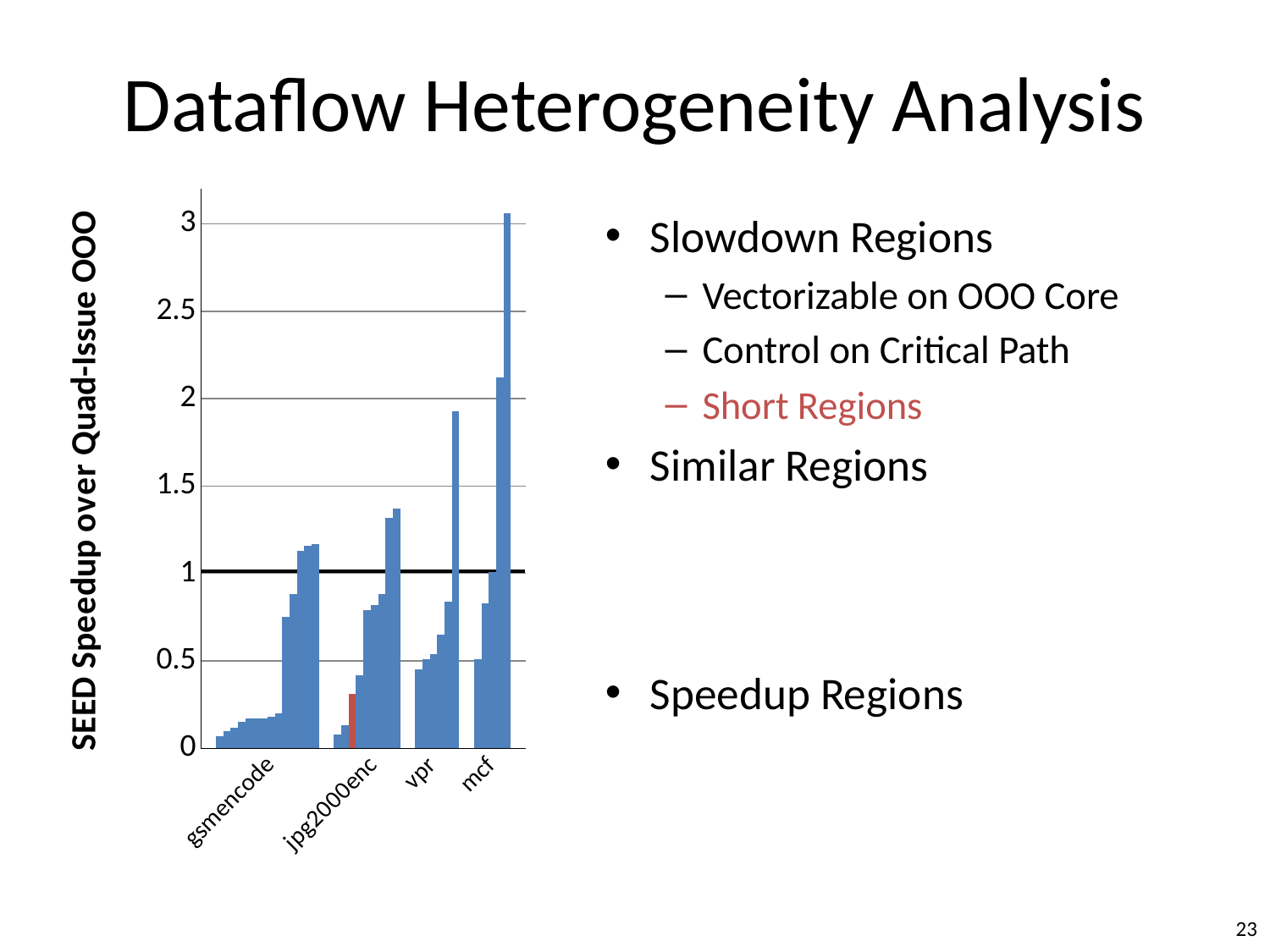
Is the tallest bar in the gsmencode group greater or less than 1.5? less How many benchmark groups are labelled on the x axis of the chart? 4 At what y-axis value is the horizontal black reference line drawn? 1 Is the tallest bar in the mcf group greater or less than 2.5? greater Which group has the taller maximum bar, vpr or gsmencode? vpr What kind of chart is shown on the slide? bar chart Is the tallest bar in the jpg2000enc group greater or less than 1.5? less What is the label of the y axis of the chart? SEED Speedup over Quad-Issue OOO Which benchmark group has the lowest bars overall? gsmencode Which benchmark group contains the tallest bar in the chart? mcf